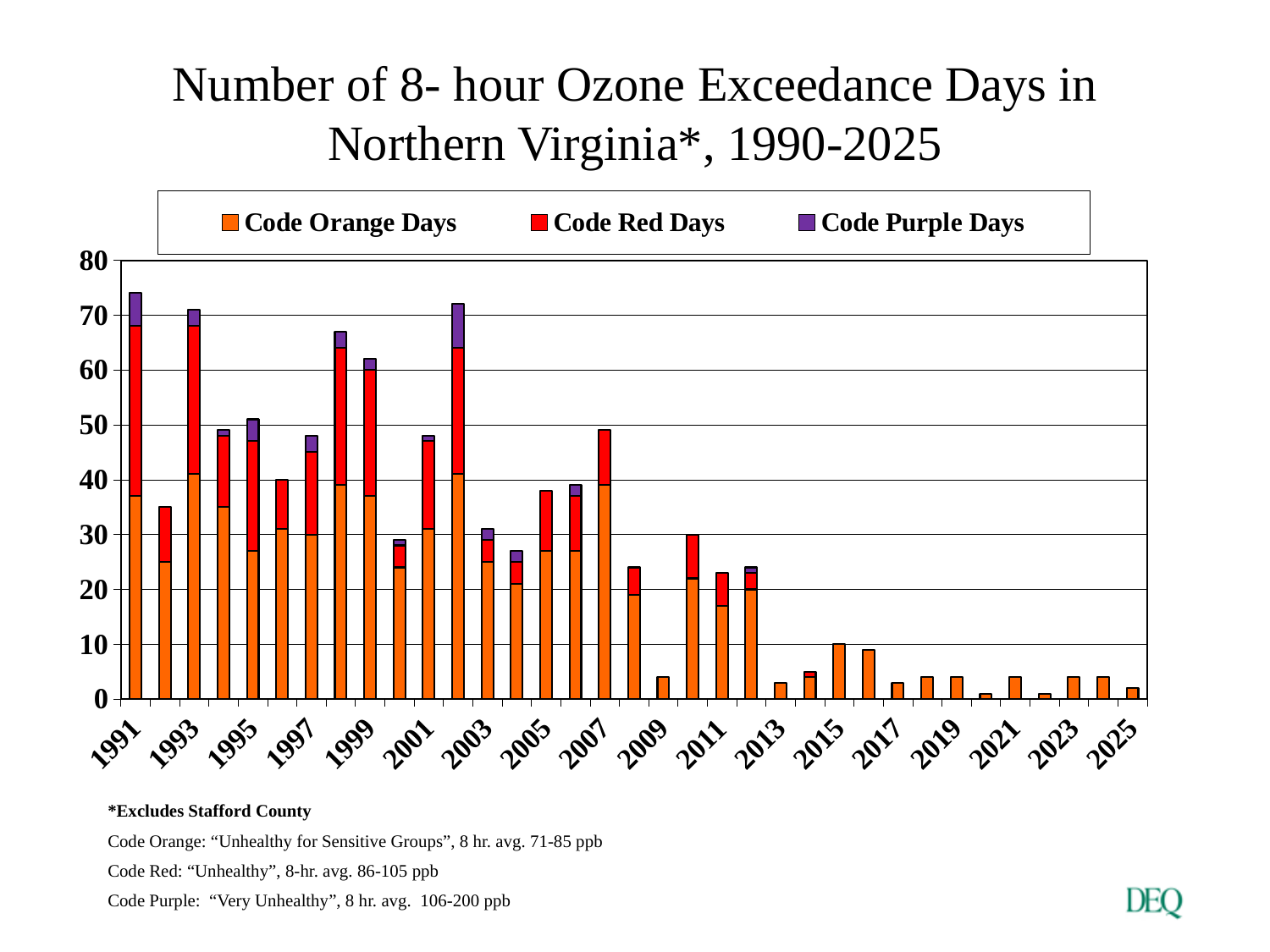
Is the total number of exceedance days for 2005 greater or less than 30? greater Is the total number of exceedance days for 1991 greater or less than 70? greater Is the total number of exceedance days for 2009 greater or less than 10? less How many series does the legend list? 3 Which series is drawn in purple? Code Purple Days What are the three series named in the legend? Code Orange Days, Code Red Days, Code Purple Days What kind of chart is shown on the slide? Stacked bar chart Overall, do the total exceedance days rise or fall from 1991 to 2025? fall Which year has more total exceedance days, 1991 or 1992? 1991 Which year has more total exceedance days, 2007 or 2009? 2007